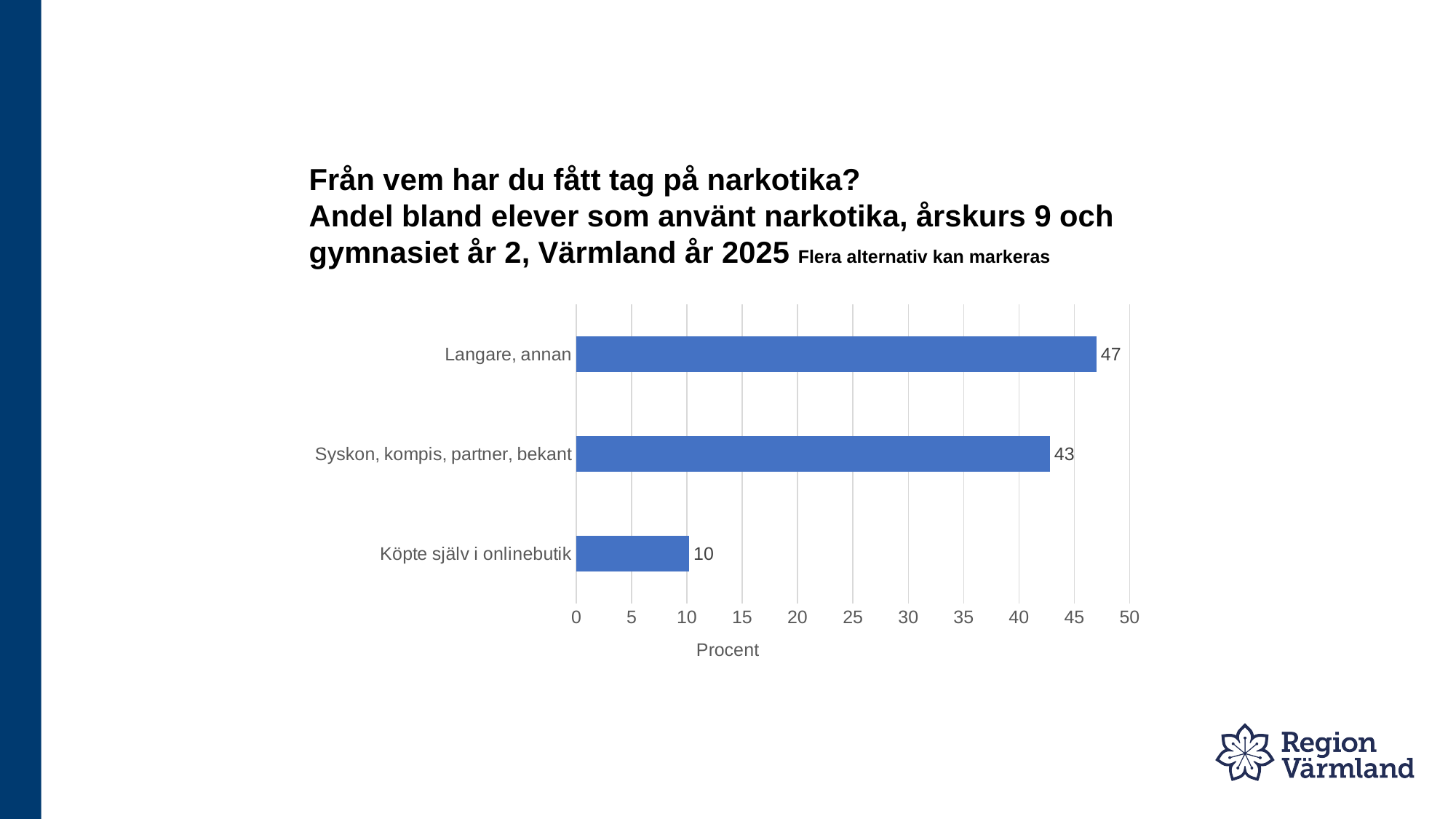
What kind of chart is shown on the slide? Bar chart Which category has the highest value? Langare, annan What is the difference between the values for "Langare, annan" and "Syskon, kompis, partner, bekant"? 4 What is the value for "Syskon, kompis, partner, bekant"? 43 What is the value for "Langare, annan"? 47 How many categories are shown in the chart? 3 What is the difference between the values for "Syskon, kompis, partner, bekant" and "Köpte själv i onlinebutik"? 33 Which category has the lowest value? Köpte själv i onlinebutik What is the label of the horizontal axis? Procent Which is larger, the value for "Langare, annan" or the value for "Köpte själv i onlinebutik"? Langare, annan What is the value for "Köpte själv i onlinebutik"? 10 Is the value for "Syskon, kompis, partner, bekant" greater or less than 40? greater